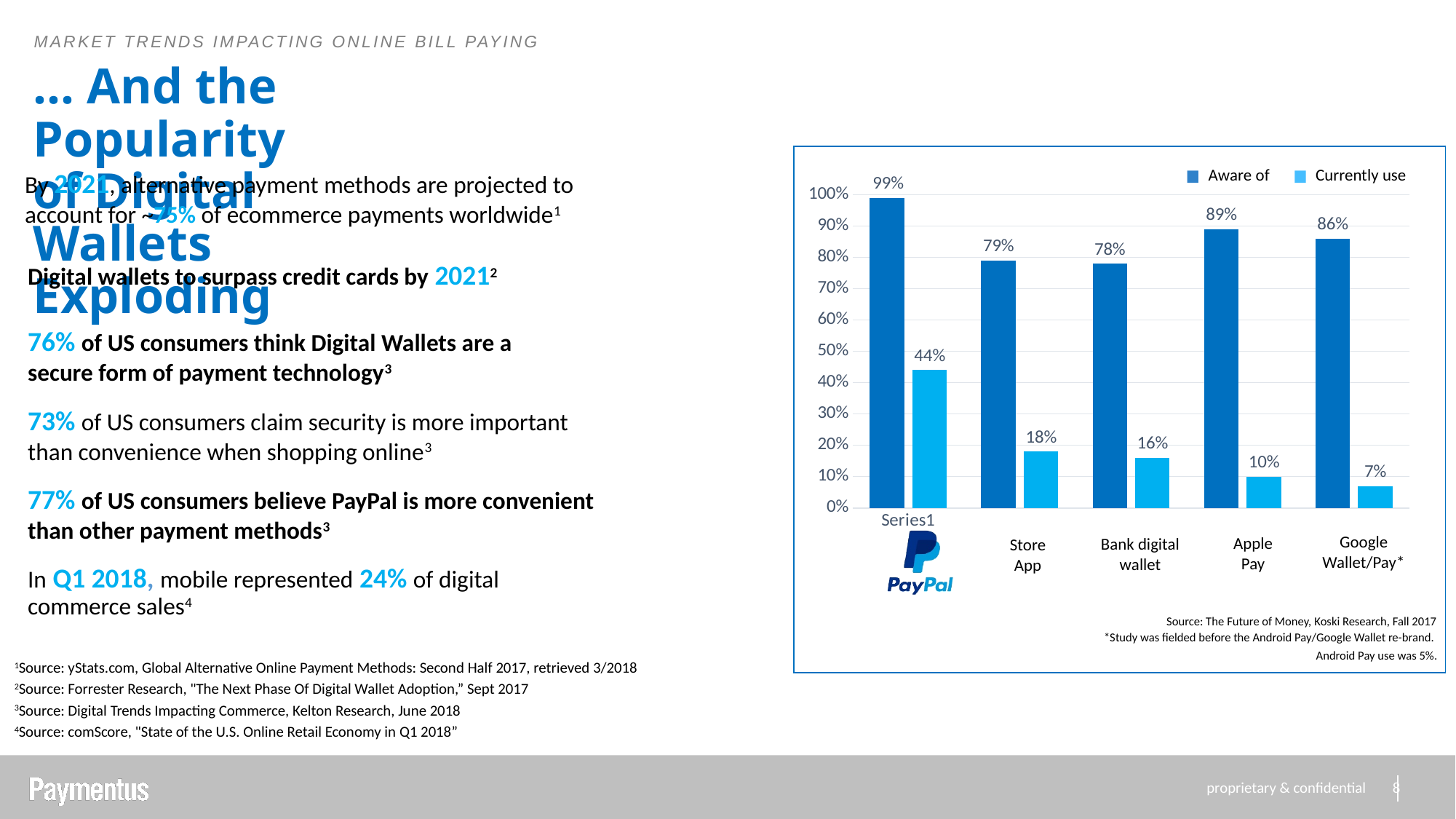
What is the 'Aware of' value for Apple Pay? 89% Which is larger, the 'Aware of' value for Google Wallet/Pay or for Store App? Google Wallet/Pay Which category has the lowest 'Aware of' value? Bank digital wallet What kind of chart is shown on the slide? Bar chart How many series does the chart legend list? 2 What is the 'Currently use' value for Store App? 18% What is the 'Aware of' value for Bank digital wallet? 78% What is the difference between the 'Aware of' and 'Currently use' values for Apple Pay? 79% What are the two series named in the chart legend? Aware of; Currently use How many categories are shown on the x axis of the chart? 5 What is the 'Currently use' value for Google Wallet/Pay? 7% Which category has the highest 'Currently use' value? PayPal